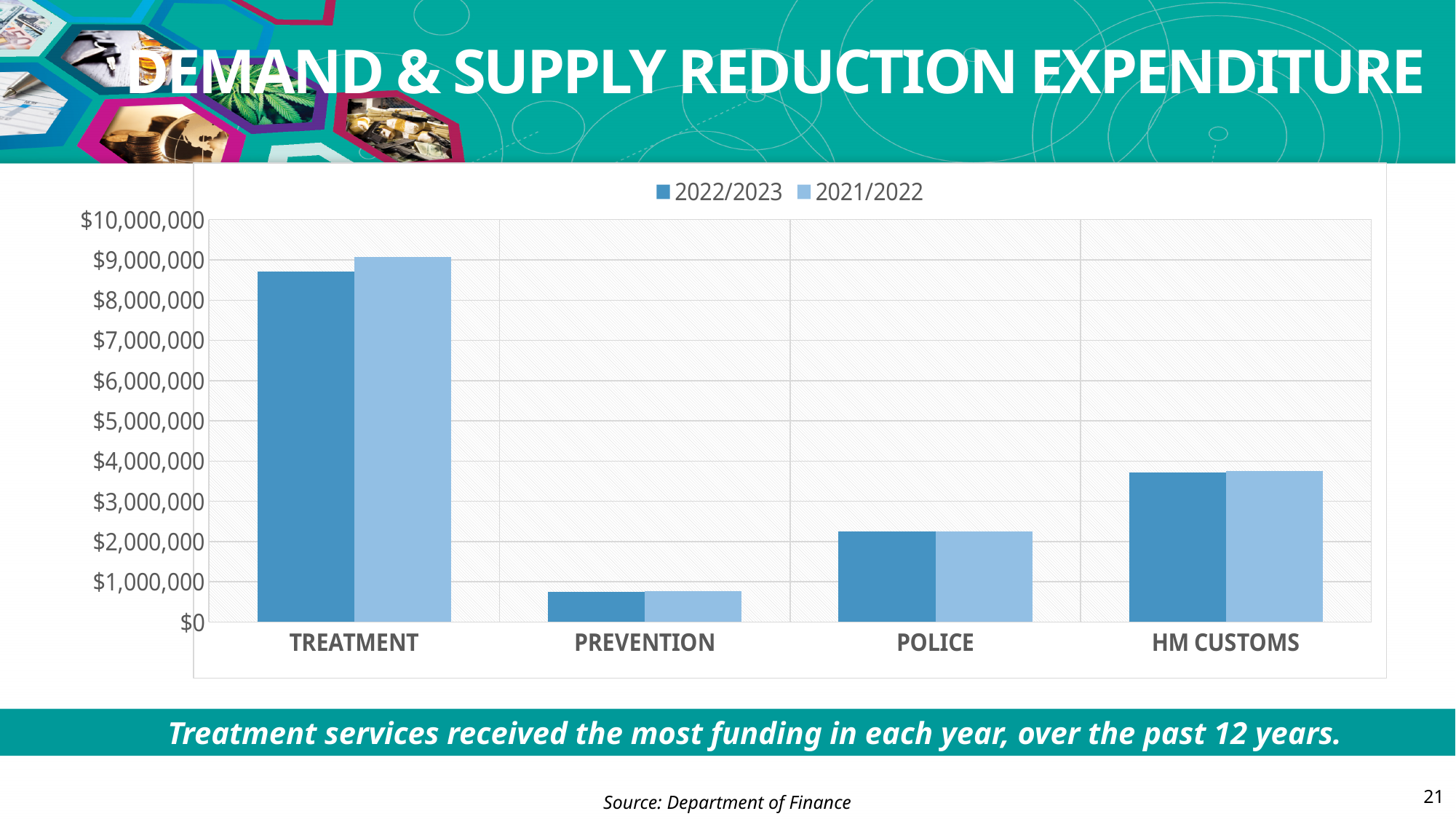
Which is larger for TREATMENT: the 2022/2023 value or the 2021/2022 value? 2021/2022 Is the 2022/2023 value for TREATMENT greater or less than $8,000,000? greater Is the 2022/2023 value for PREVENTION greater or less than $1,000,000? less Which category has the highest expenditure in 2022/2023? TREATMENT Which category has the larger 2022/2023 expenditure: POLICE or HM CUSTOMS? HM CUSTOMS How many series does the chart's legend list? 2 Which category has the lowest expenditure in 2021/2022? PREVENTION Is the 2021/2022 value for HM CUSTOMS greater or less than $3,000,000? greater What kind of chart is shown on the slide? bar chart What are the two series named in the chart's legend? 2022/2023 and 2021/2022 How many categories are shown on the x axis of the chart? 4